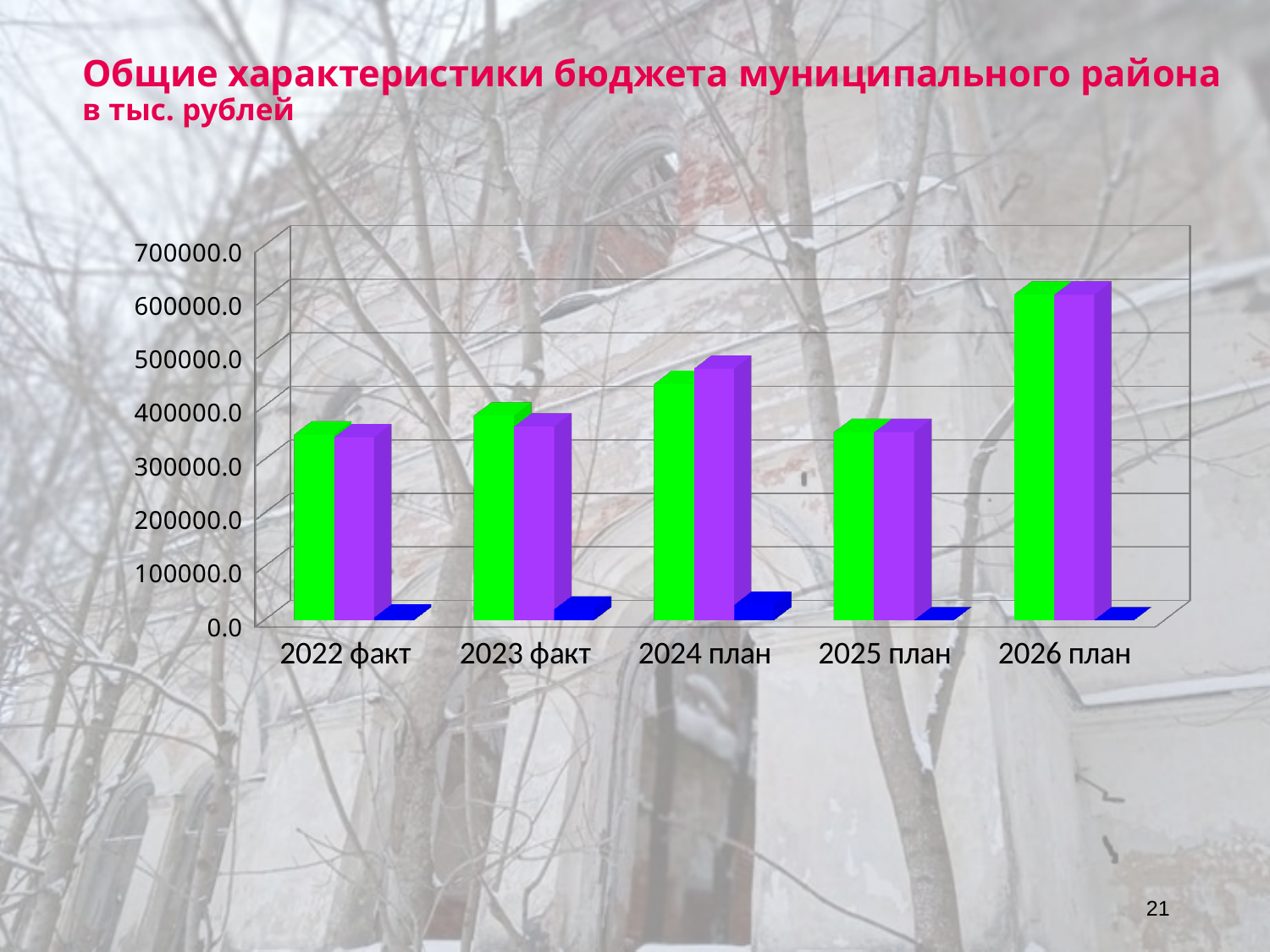
Is the value of the blue bar for 2024 план greater or less than 100000.0? less What is the title of the chart on the slide? Общие характеристики бюджета муниципального района How many categories are shown on the x axis of the chart? 5 For which category is the green bar the highest? 2026 план In what units are the values on the chart given, according to the subtitle? в тыс. рублей What kind of chart is shown on the slide? bar chart Is the value of the green bar for 2026 план greater or less than 600000.0? greater Is the value of the green bar for 2024 план greater or less than 500000.0? less Which is larger: the green bar for 2024 план or the green bar for 2025 план? 2024 план For which category is the purple bar the highest? 2026 план